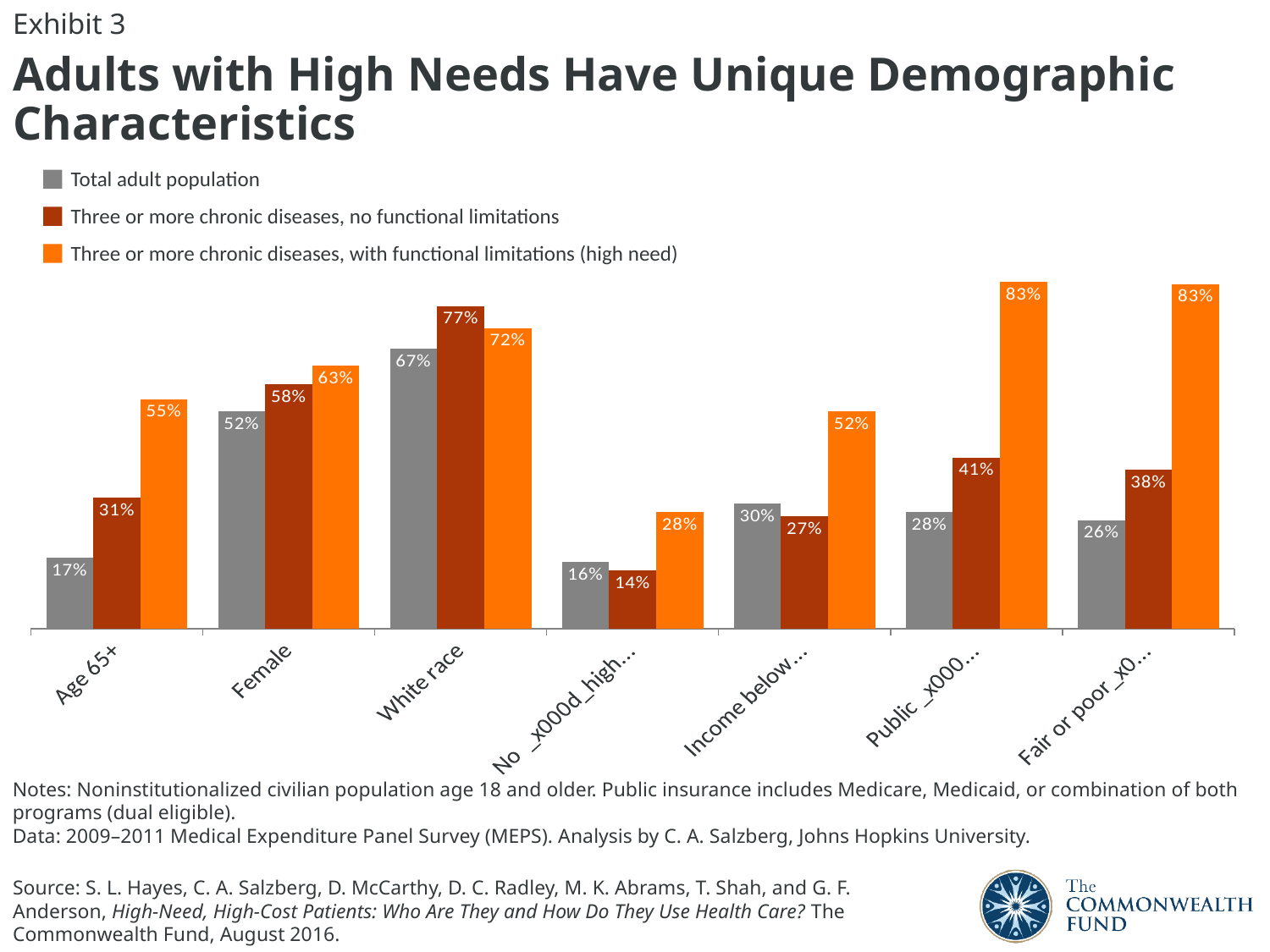
How many categories are shown along the x axis? 7 What is the value for the 'Three or more chronic diseases, with functional limitations (high need)' series in the Female category? 63% What is the value for Total adult population in the Age 65+ category? 17% In the White race category, what is the difference between the 'no functional limitations' value and the Total adult population value? 10 percentage points What kind of chart is shown on the slide? Bar chart Which category has the highest value for the Total adult population series? White race How many series does the legend list? 3 What colour represents the 'Three or more chronic diseases, with functional limitations (high need)' series? Orange In the White race category, which is larger: the 'no functional limitations' value or the 'high need' value? Three or more chronic diseases, no functional limitations What is the value for the 'Three or more chronic diseases, no functional limitations' series in the White race category? 77% Among Age 65+, Female and White race, which category has the lowest value for the high need series? Age 65+ In the Age 65+ category, how much higher is the high need value than the Total adult population value? 38 percentage points